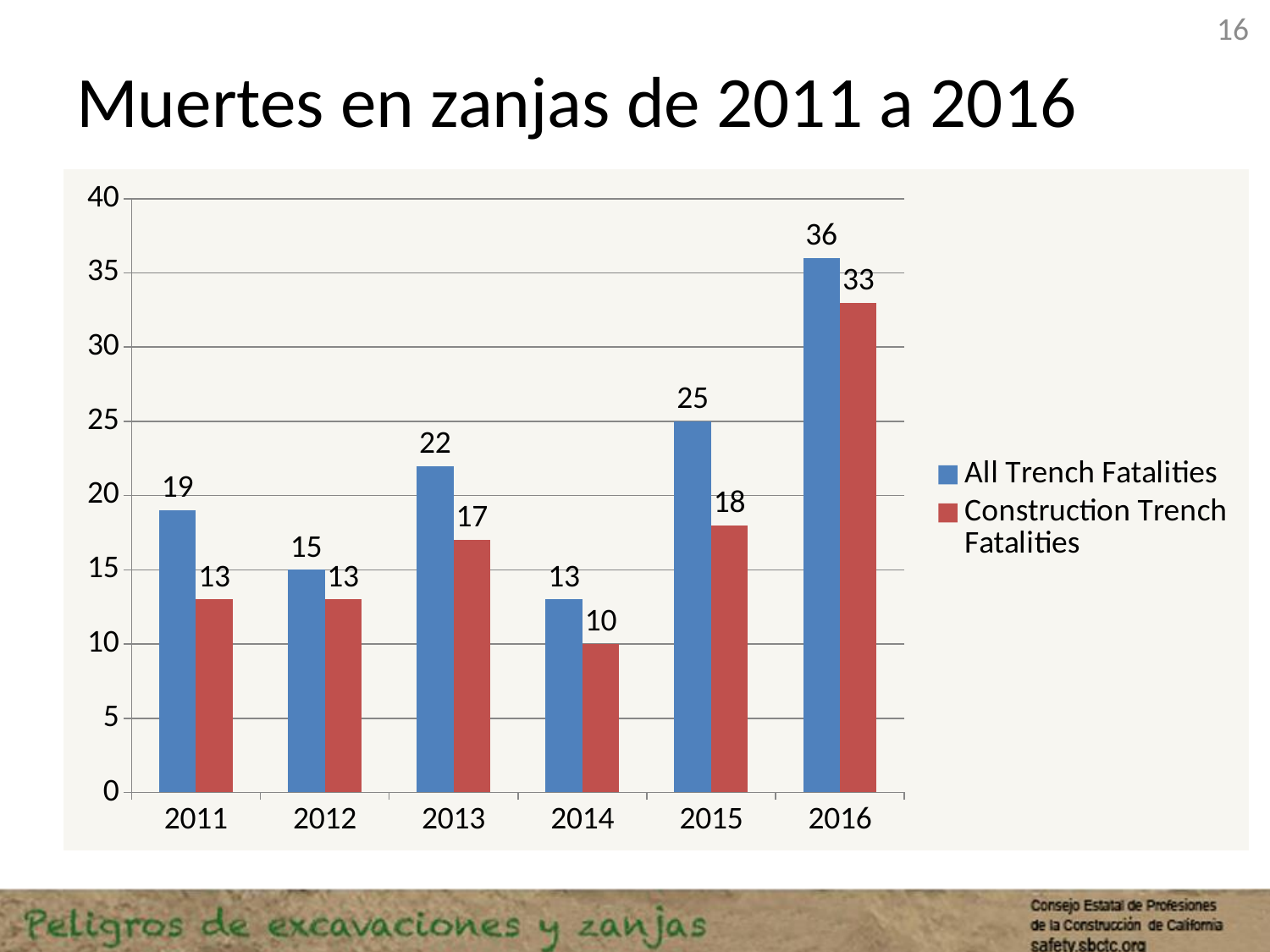
Which year has the highest value for All Trench Fatalities? 2016 What is the value for All Trench Fatalities in 2013? 22 What kind of chart is shown on the slide? bar chart What is the title of the slide? Muertes en zanjas de 2011 a 2016 Is the value for All Trench Fatalities in 2015 greater or less than 20? greater How many years are shown on the x axis? 6 Which year has the lowest value for Construction Trench Fatalities? 2014 Do the values for All Trench Fatalities rise or fall from 2014 to 2016? rise How many series does the legend list? 2 What is the value for Construction Trench Fatalities in 2015? 18 Which is larger: All Trench Fatalities in 2012 or All Trench Fatalities in 2014? All Trench Fatalities in 2012 What is the difference between All Trench Fatalities and Construction Trench Fatalities in 2016? 3